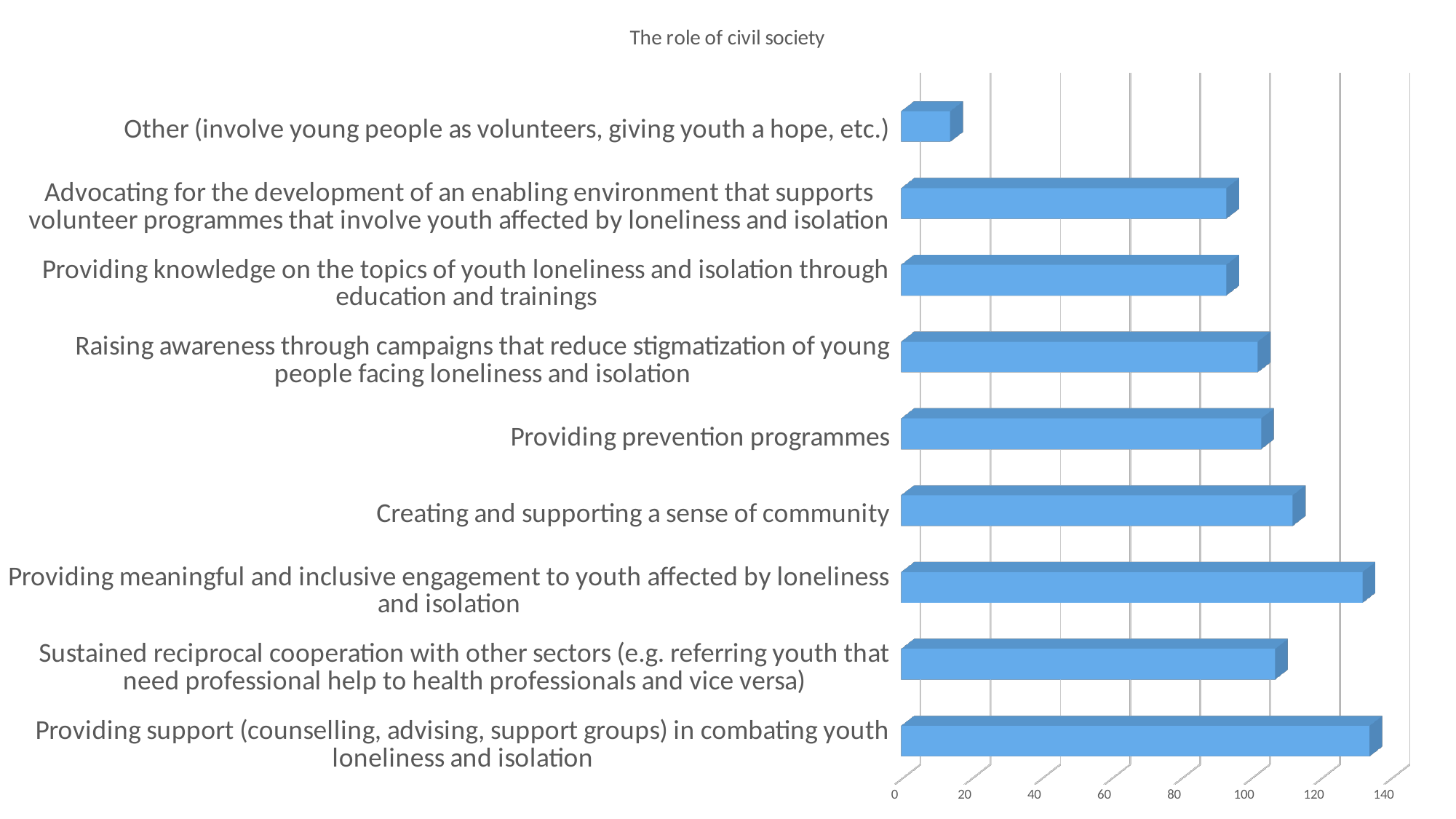
What type of chart is shown on the slide? bar chart Is the value for 'Other (involve young people as volunteers, giving youth a hope, etc.)' greater or less than 20? less Is the value for 'Creating and supporting a sense of community' greater or less than 120? less Which has a larger value: 'Providing meaningful and inclusive engagement to youth affected by loneliness and isolation' or 'Sustained reciprocal cooperation with other sectors (e.g. referring youth that need professional help to health professionals and vice versa)'? Providing meaningful and inclusive engagement to youth affected by loneliness and isolation How many categories are plotted in the chart? 9 Is the value for 'Providing meaningful and inclusive engagement to youth affected by loneliness and isolation' greater or less than 120? greater Which category has the lowest value? Other (involve young people as volunteers, giving youth a hope, etc.) What is the title of the chart? The role of civil society Which has a larger value: 'Creating and supporting a sense of community' or 'Providing prevention programmes'? Creating and supporting a sense of community